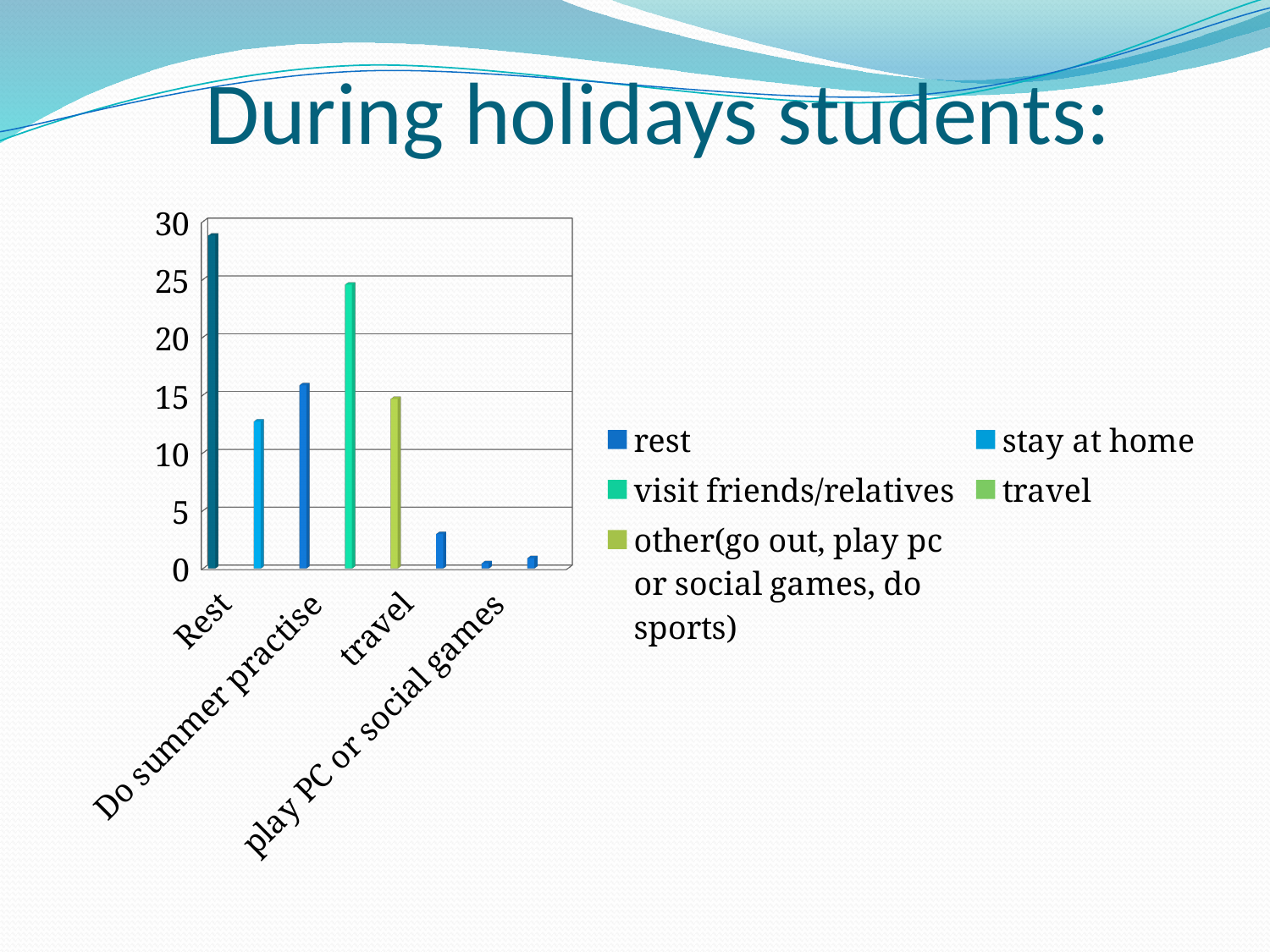
Is the green 'visit friends/relatives' bar greater or less than 20? greater Which legend entry is shown with the green colour? visit friends/relatives How many category labels are shown along the x axis of the chart? 4 Is the yellow-green 'travel' bar greater or less than 10? greater How many series does the chart's legend list? 5 What kind of chart is shown on the slide? bar chart Is the tallest bar in the chart greater or less than 25? greater Which is taller, the green 'visit friends/relatives' bar or the light blue 'stay at home' bar? the green 'visit friends/relatives' bar Which is taller, the dark blue 'rest' bar or the green 'visit friends/relatives' bar? the dark blue 'rest' bar What is the title of the slide containing the chart? During holidays students: What is the highest value shown on the chart's vertical axis? 30